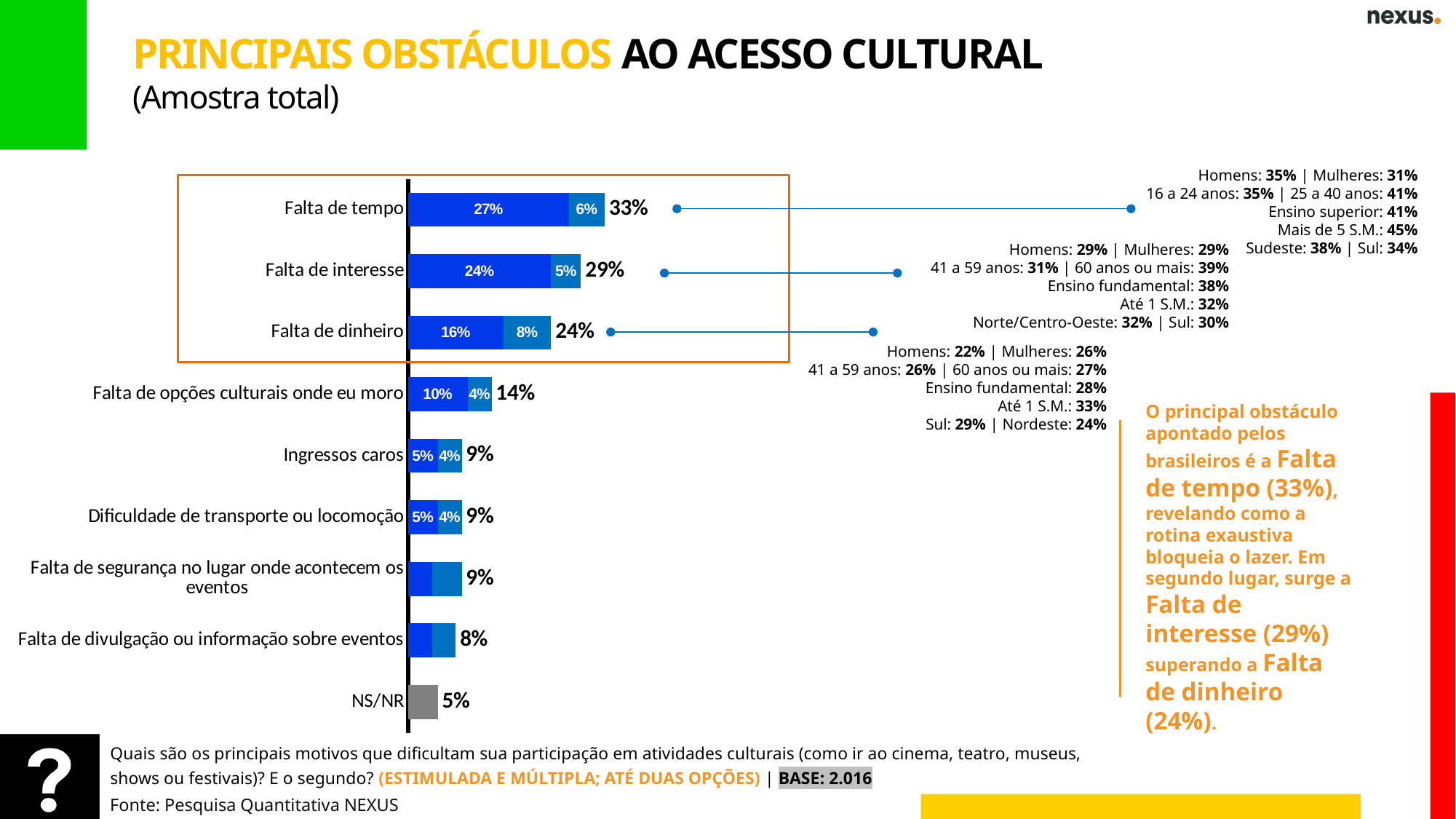
What is the value of the second (lighter blue) segment of the "Falta de dinheiro" bar? 8% How many categories are shown in the chart? 9 Which has a larger total value, "Falta de opções culturais onde eu moro" or "Ingressos caros"? Falta de opções culturais onde eu moro Which category has the lowest total value? NS/NR What is the sum of the two segments of the "Falta de opções culturais onde eu moro" bar? 14% What is the total value shown for "Falta de divulgação ou informação sobre eventos"? 8% What is the difference between the total values for "Falta de tempo" and "Falta de interesse"? 4% What kind of chart is shown on the slide? Stacked bar chart What is the total value shown for "Falta de dinheiro"? 24% Which category has the highest total value? Falta de tempo What is the value of the first (dark blue) segment of the "Falta de interesse" bar? 24% What is the total value shown for "Falta de tempo"? 33%